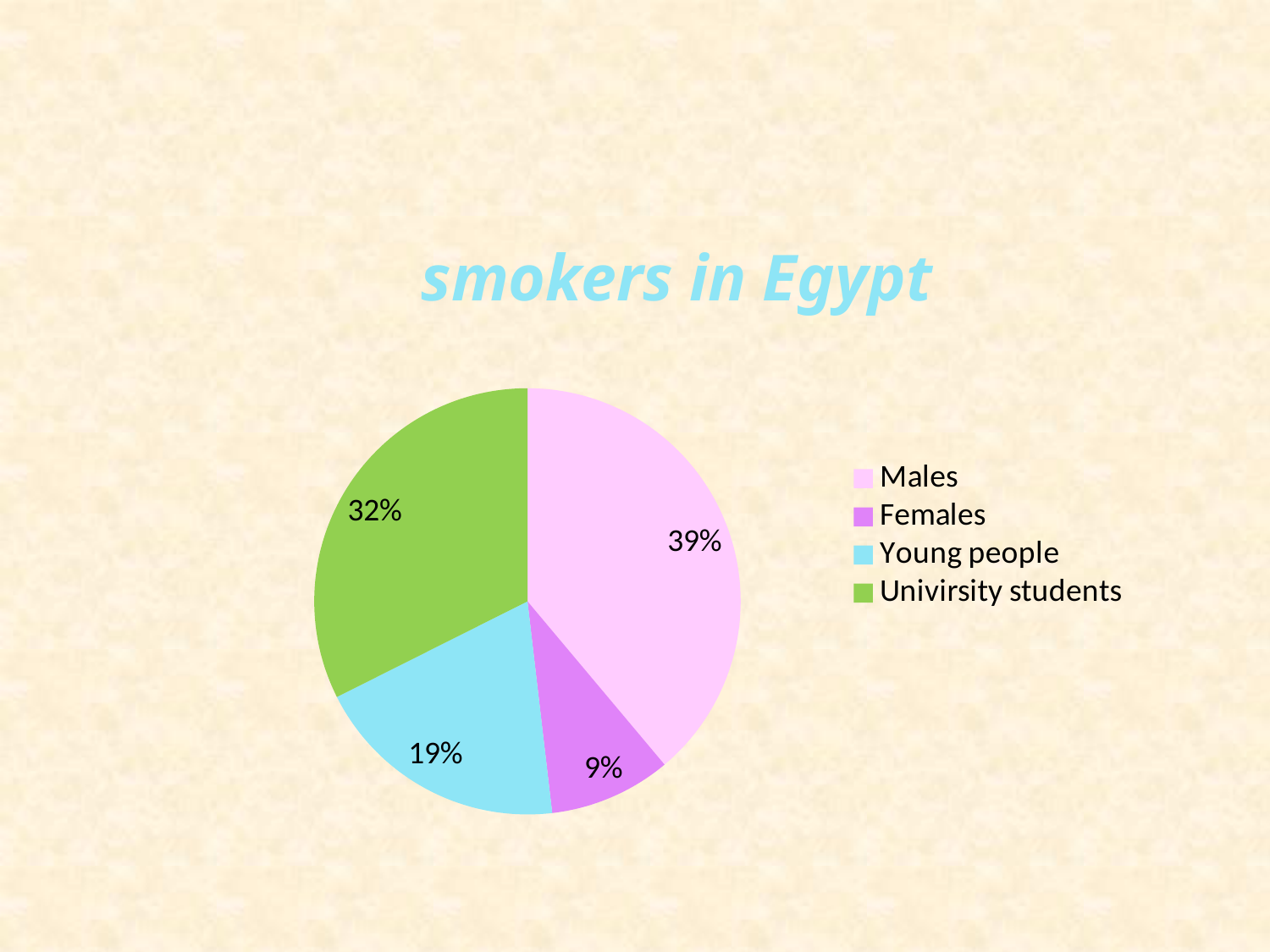
Which category has the smallest slice of the pie chart? Females What is the title of the chart? smokers in Egypt What is the difference in percentage points between the Males slice and the Females slice? 30 What percentage of the pie chart is the Young people slice? 19% Which slice is larger, Young people or Univirsity students? Univirsity students Which colour represents Young people in the pie chart? Light blue What percentage of the pie chart is the Univirsity students slice? 32% What percentage of the pie chart is the Females slice? 9% What kind of chart is shown on the slide? Pie chart How many slices does the pie chart have? 4 What percentage of the pie chart is the Males slice? 39% Which category has the largest slice of the pie chart? Males